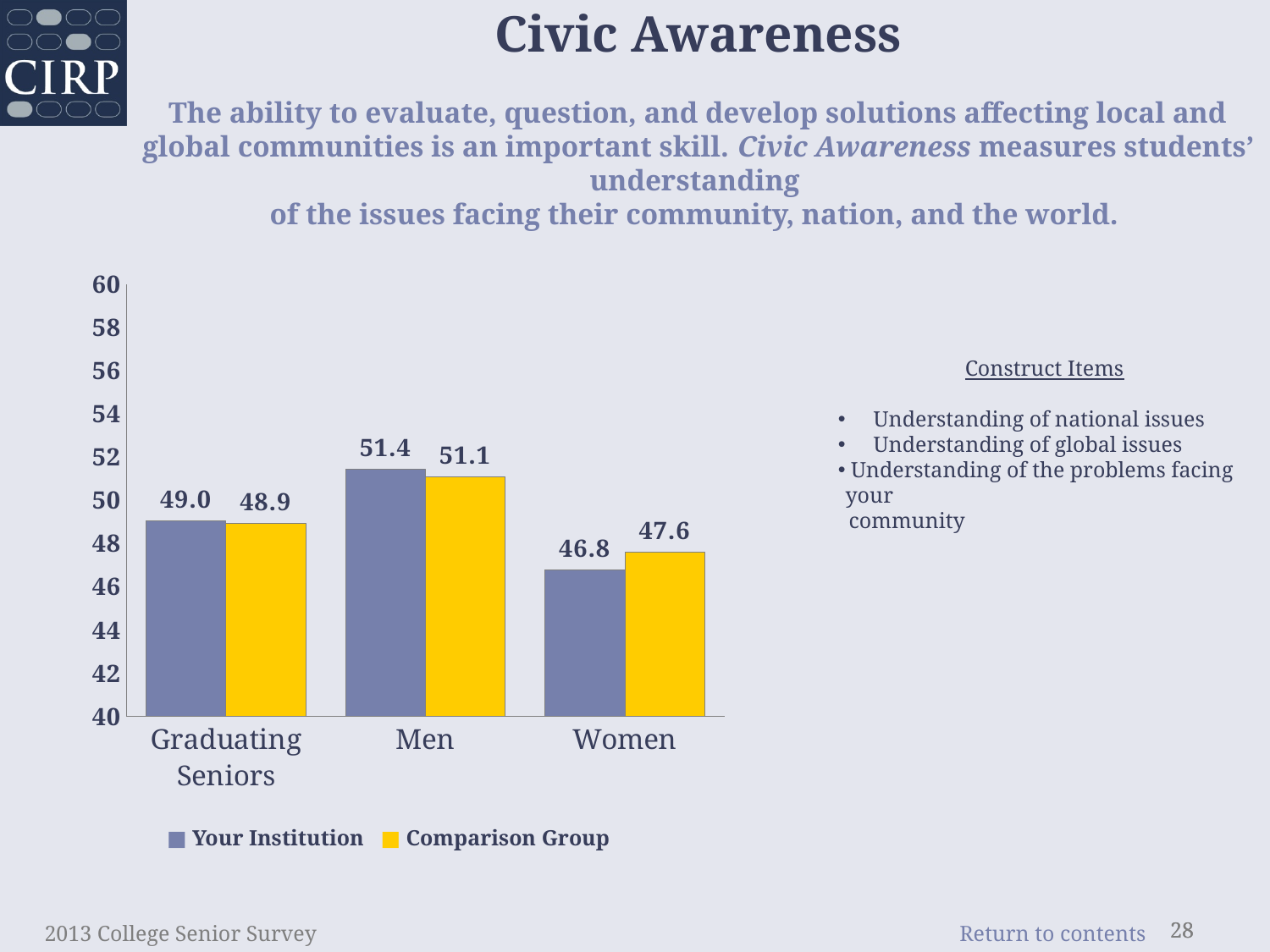
How many categories are shown on the x axis? 3 What kind of chart is shown on the slide? bar chart What is the Your Institution value for Men? 51.4 What is the difference between the Your Institution and Comparison Group values for Women? 0.8 Which category has the highest Your Institution value? Men What is the Your Institution value for Graduating Seniors? 49.0 Which category has the lowest Comparison Group value? Women For Women, which is larger: Your Institution or Comparison Group? Comparison Group What is the Comparison Group value for Women? 47.6 Is the Comparison Group value for Men greater or less than 50? greater What is the difference between the Your Institution values for Men and Women? 4.6 How many series does the legend list? 2